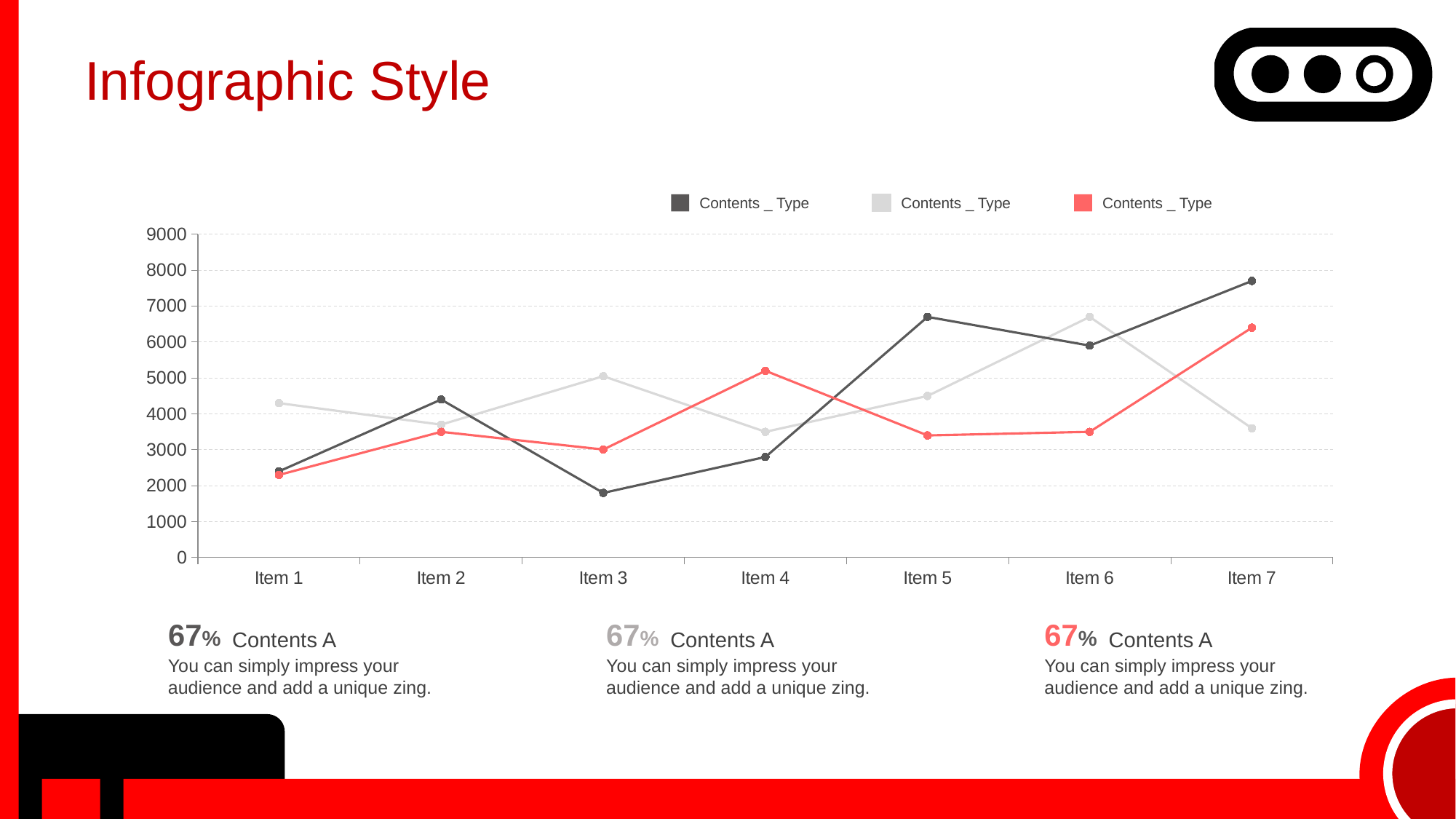
At which item does the light grey series reach its highest value? Item 6 At Item 5, which series has the larger value, the dark grey series or the red series? the dark grey series Is the value of the red series at Item 7 greater or less than 6000? greater Is the value of the dark grey series at Item 3 greater or less than 2000? less Is the value of the light grey series at Item 6 greater or less than 6000? greater What kind of chart is shown on the slide? line chart How many items are plotted along the x axis of the chart? 7 What label is used for each of the three legend entries? Contents _ Type How many series does the chart's legend list? 3 At which item does the dark grey series reach its highest value? Item 7 At which item does the dark grey series reach its lowest value? Item 3